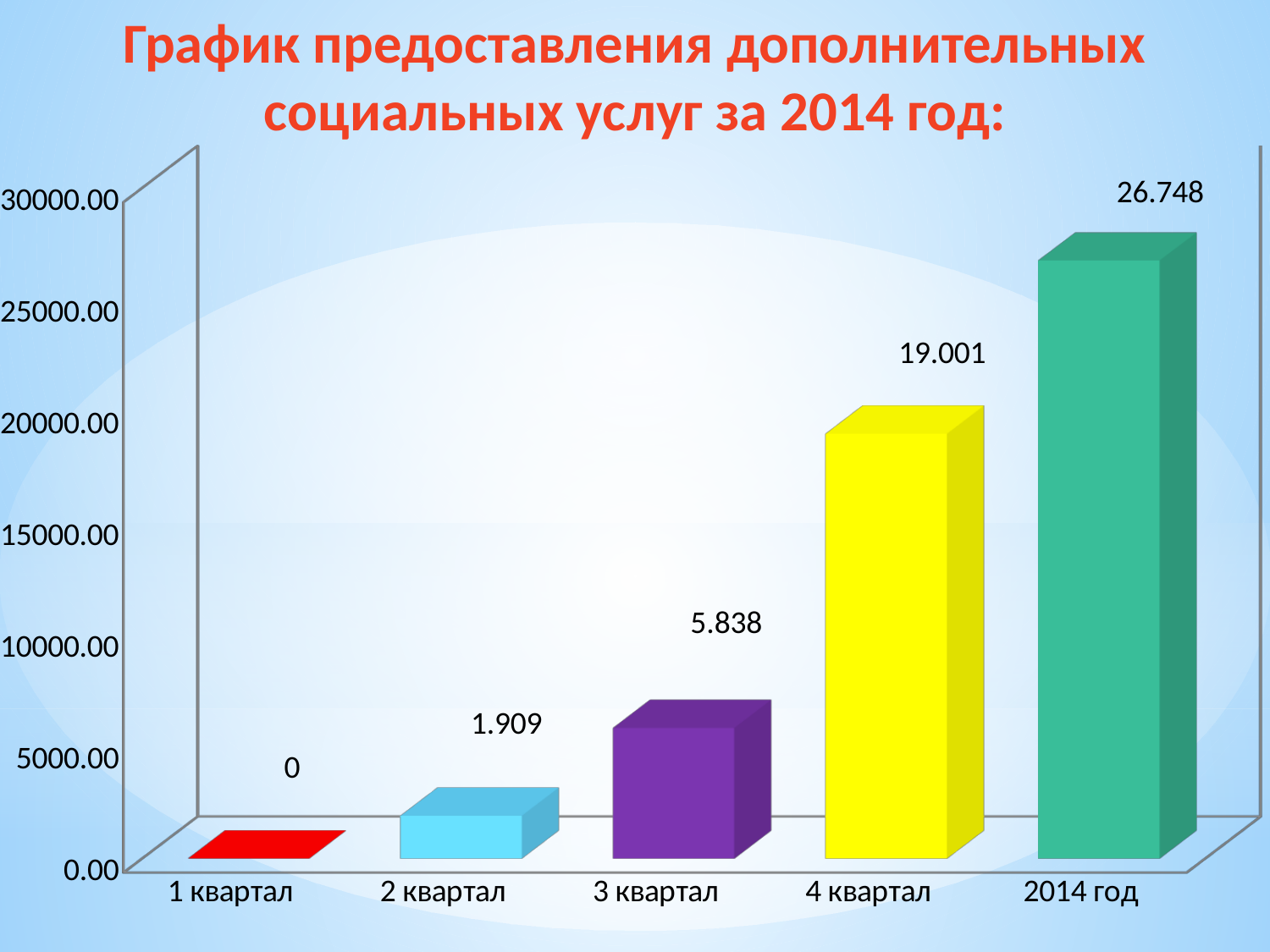
Is the value for 3 квартал greater or less than 10000.00? less What value is shown for 3 квартал? 5.838 What kind of chart is shown on the slide? bar chart Which category has the highest value? 2014 год Which category has the lowest value? 1 квартал What value is shown for 2 квартал? 1.909 Which is larger, the value for 3 квартал or the value for 4 квартал? 4 квартал How many categories are shown on the x axis? 5 What value is shown for 2014 год? 26.748 Is the value for 2014 год greater or less than 25000.00? greater What value is shown for 4 квартал? 19.001 Do the values rise or fall from 1 квартал to 4 квартал? rise